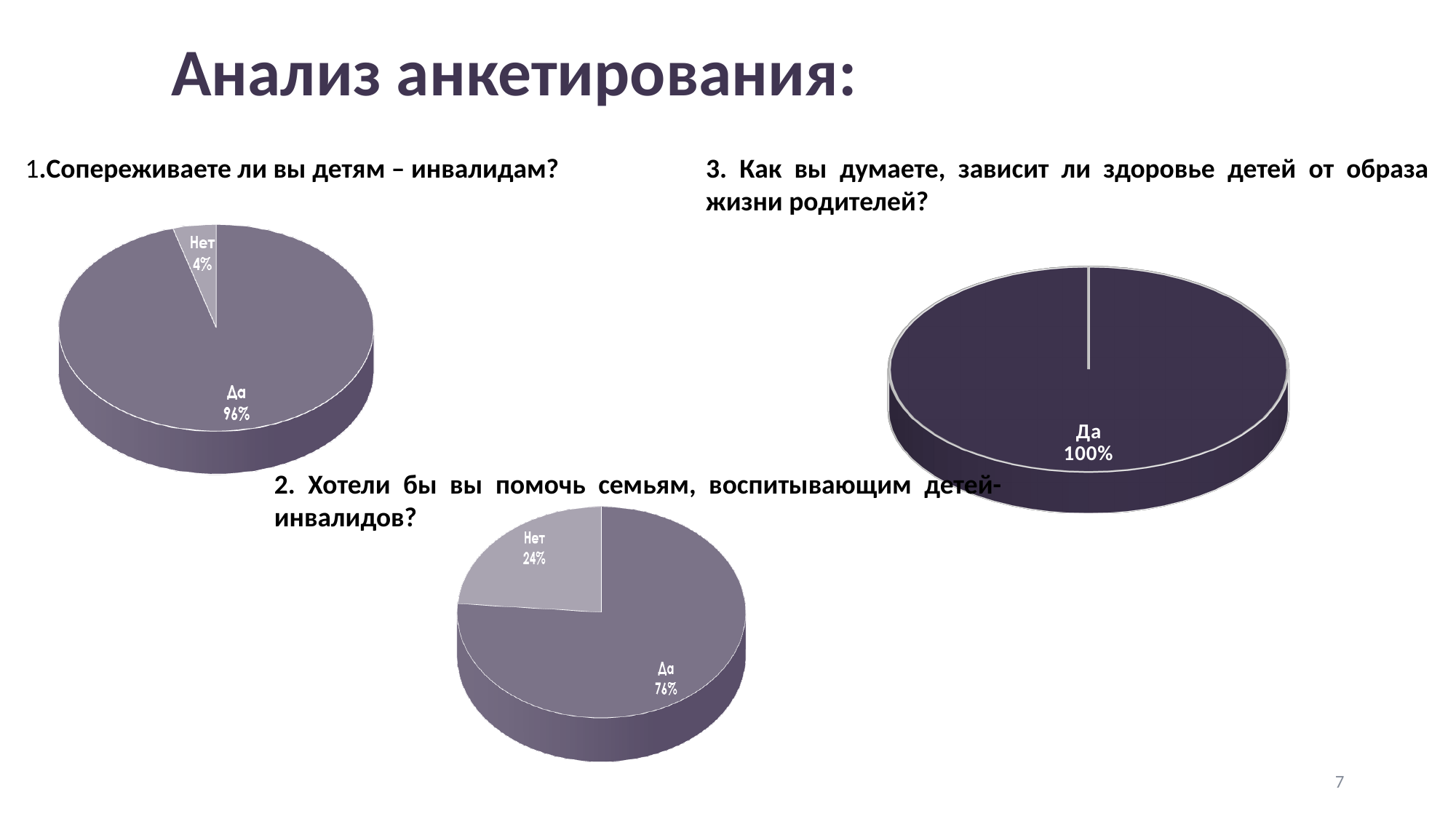
In the pie chart for question 2 ("Хотели бы вы помочь семьям, воспитывающим детей-инвалидов?"), what share is labelled "Да"? 76% In the pie chart for question 1 (top left), what is the difference between the "Да" and "Нет" shares? 92% In the pie chart for question 2 (bottom centre), what is the difference between the "Да" and "Нет" shares? 52% In the pie chart for question 2 ("Хотели бы вы помочь семьям, воспитывающим детей-инвалидов?"), what share is labelled "Нет"? 24% How many charts are shown on the slide? 3 In the pie chart for question 1 ("Сопереживаете ли вы детям – инвалидам?"), what share is labelled "Да"? 96% In the pie chart for question 1 (top left), which slice is the smallest? Нет How many slices are labelled in the pie chart for question 2 (bottom centre)? 2 What type of chart is used for question 3 (right side of the slide)? Pie chart In the pie chart for question 2 (bottom centre), which slice is larger, "Да" or "Нет"? Да